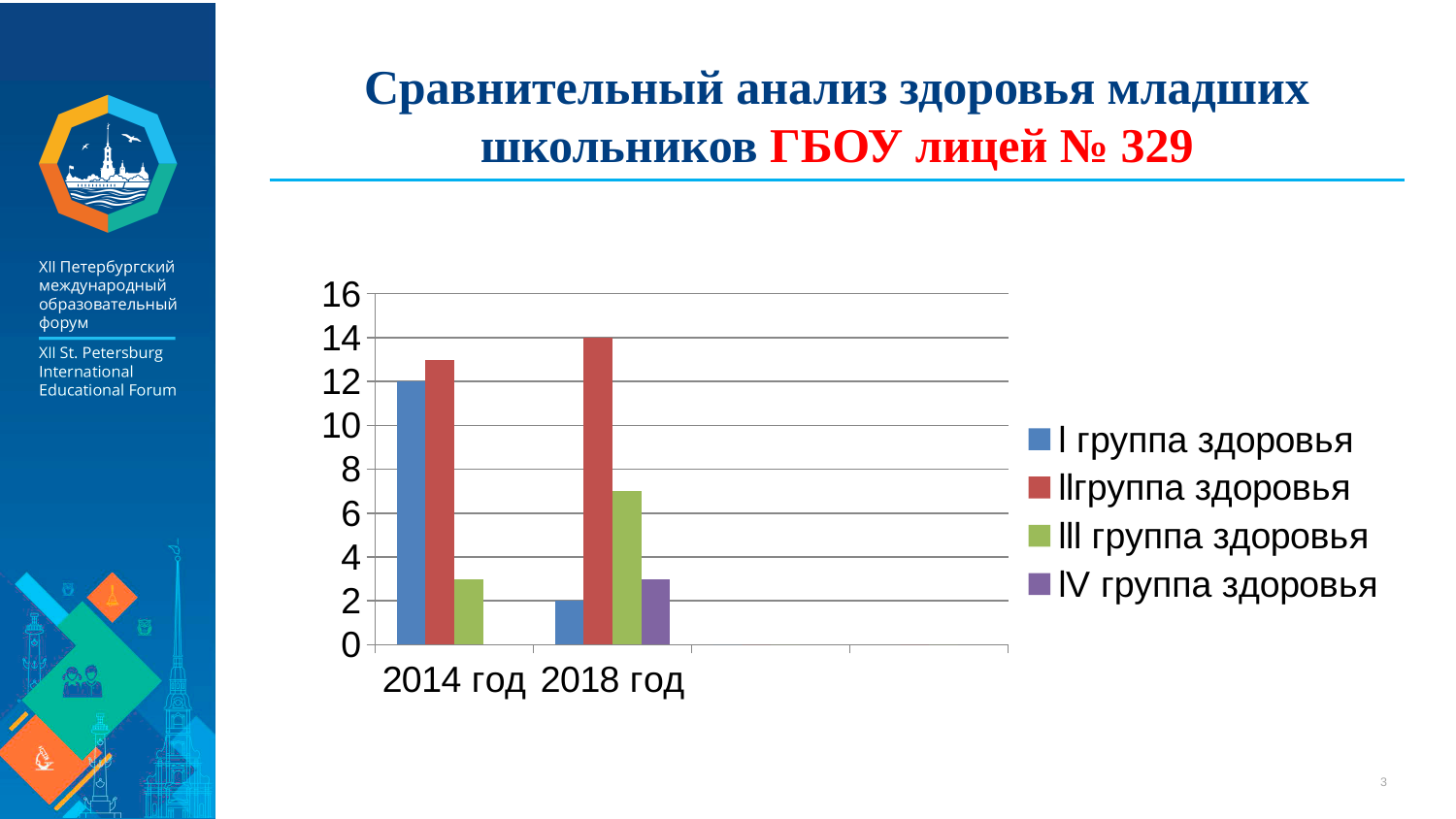
Which health group has the highest value in 2018 год? IIгруппа здоровья Is the value for IV группа здоровья in 2018 год greater or less than 4? less How many year categories are shown on the x axis? 2 How many series does the legend list? 4 Is the value for III группа здоровья in 2018 год greater or less than 6? greater What is the value for I группа здоровья in 2018 год? 2 Does the value for I группа здоровья rise or fall from 2014 год to 2018 год? fall What colour represents IV группа здоровья in the legend? purple Is the value for I группа здоровья larger in 2014 год or in 2018 год? 2014 год Which health group has the lowest value in 2018 год? I группа здоровья What kind of chart is shown on the slide? bar chart Which health group has the highest value in 2014 год? IIгруппа здоровья